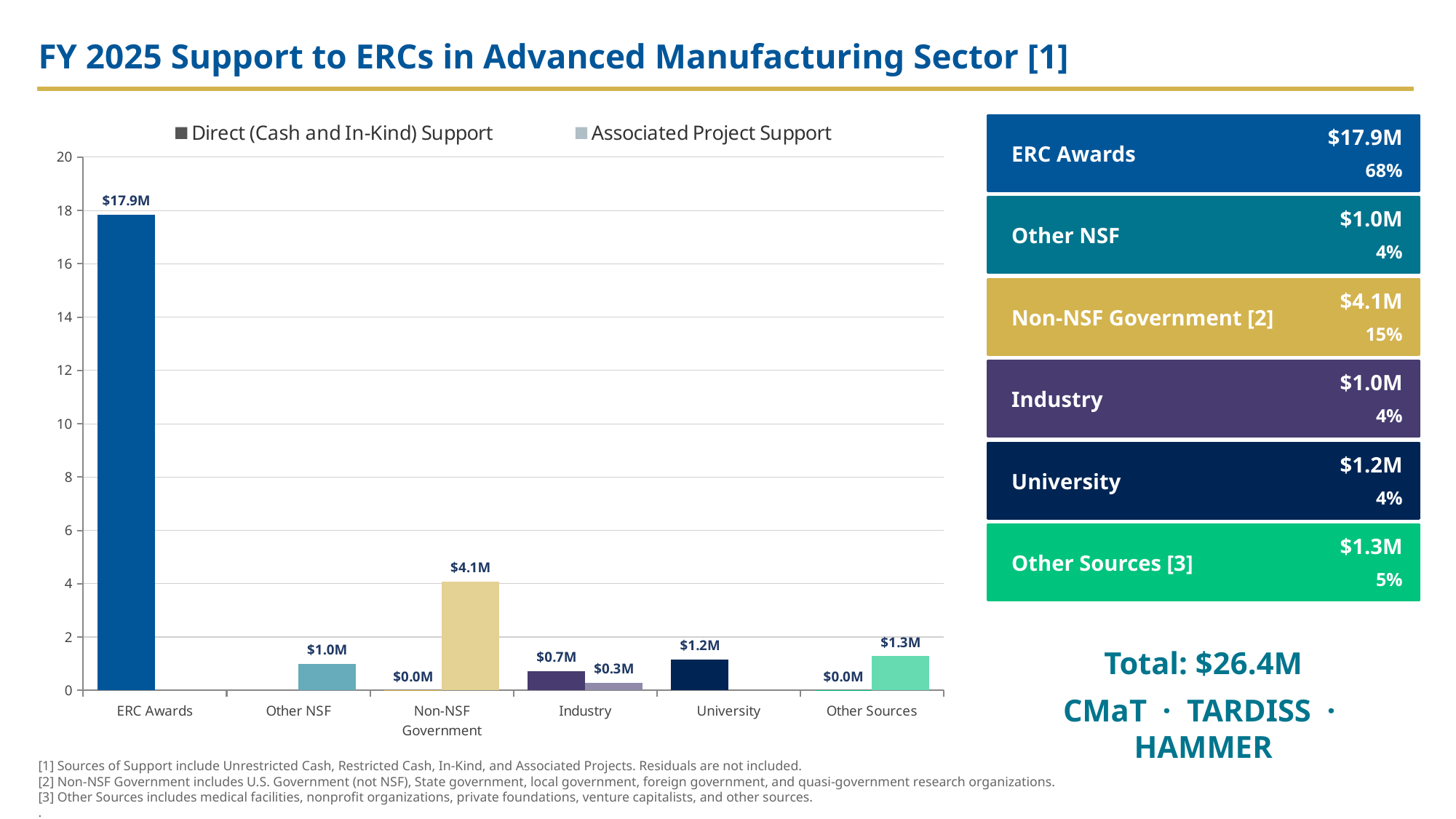
What is the Direct (Cash and In-Kind) Support value for Industry? $0.7M Which is larger: the University bar or the Other Sources Associated Project Support bar? Other Sources What is the Associated Project Support value for Non-NSF Government? $4.1M Which category has the tallest bar in the chart? ERC Awards How many categories are shown on the x axis of the chart? 6 Is the value for ERC Awards greater or less than 16? greater How many series does the chart legend list? 2 What is the Associated Project Support value for Industry? $0.3M What is the Direct (Cash and In-Kind) Support value for ERC Awards? $17.9M What kind of chart is shown on the slide? bar chart What is the difference between Industry's Direct support ($0.7M) and its Associated Project Support ($0.3M)? $0.4M What is the difference between the ERC Awards bar ($17.9M) and the Non-NSF Government Associated Project Support bar ($4.1M)? $13.8M